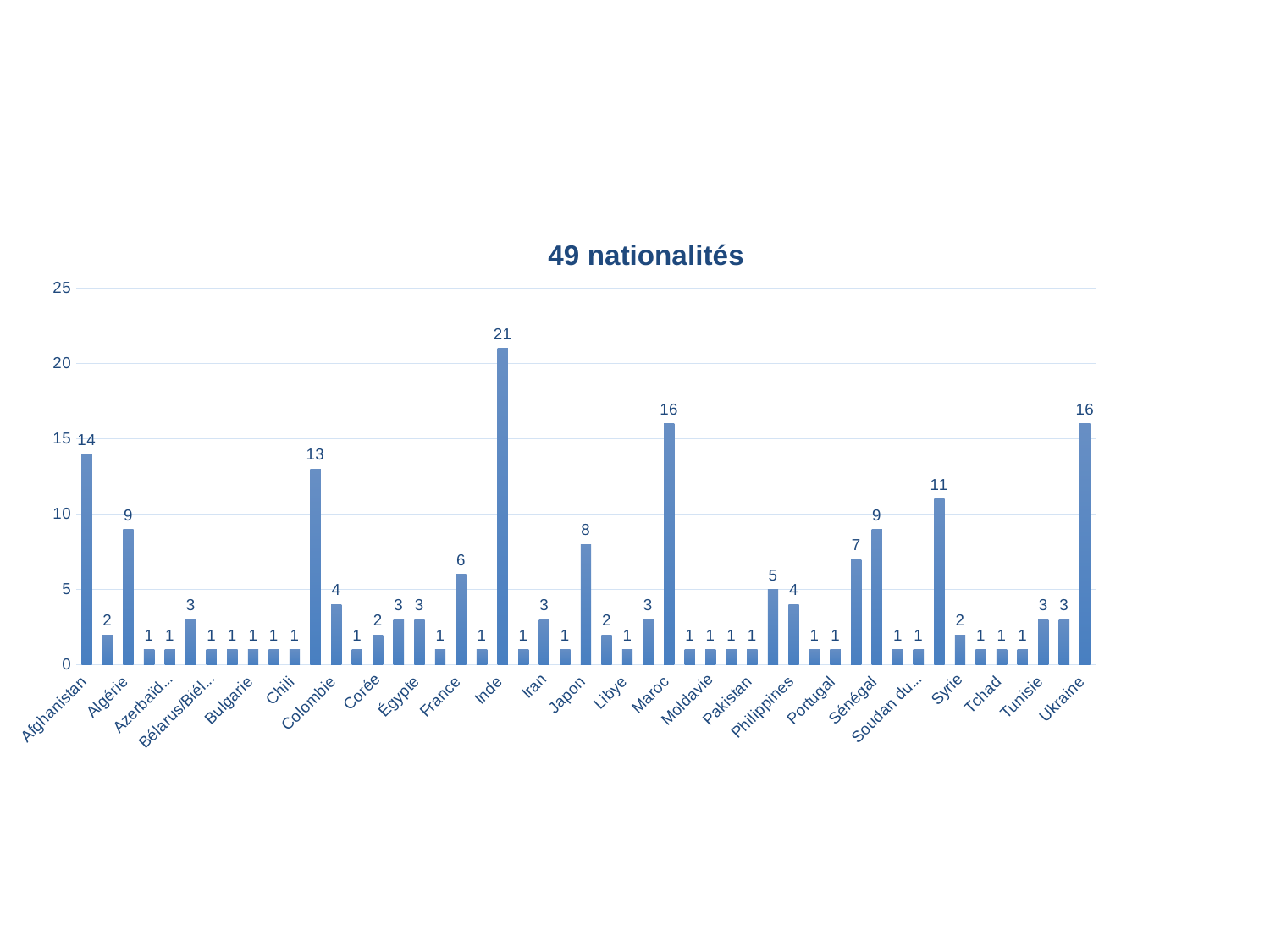
What is the value for France? 6 Which nationality has the highest value? Inde What is the difference between the values for Inde and Maroc? 5 What is the value for Maroc? 16 Is the value for Ukraine greater or less than 15? greater Which has a larger value, Japon or Algérie? Algérie What type of chart is shown on the slide? bar chart What is the value for Inde? 21 How many bars are plotted in the chart? 49 What is the value for Afghanistan? 14 What is the title of the chart? 49 nationalités What is the value for Sénégal? 9